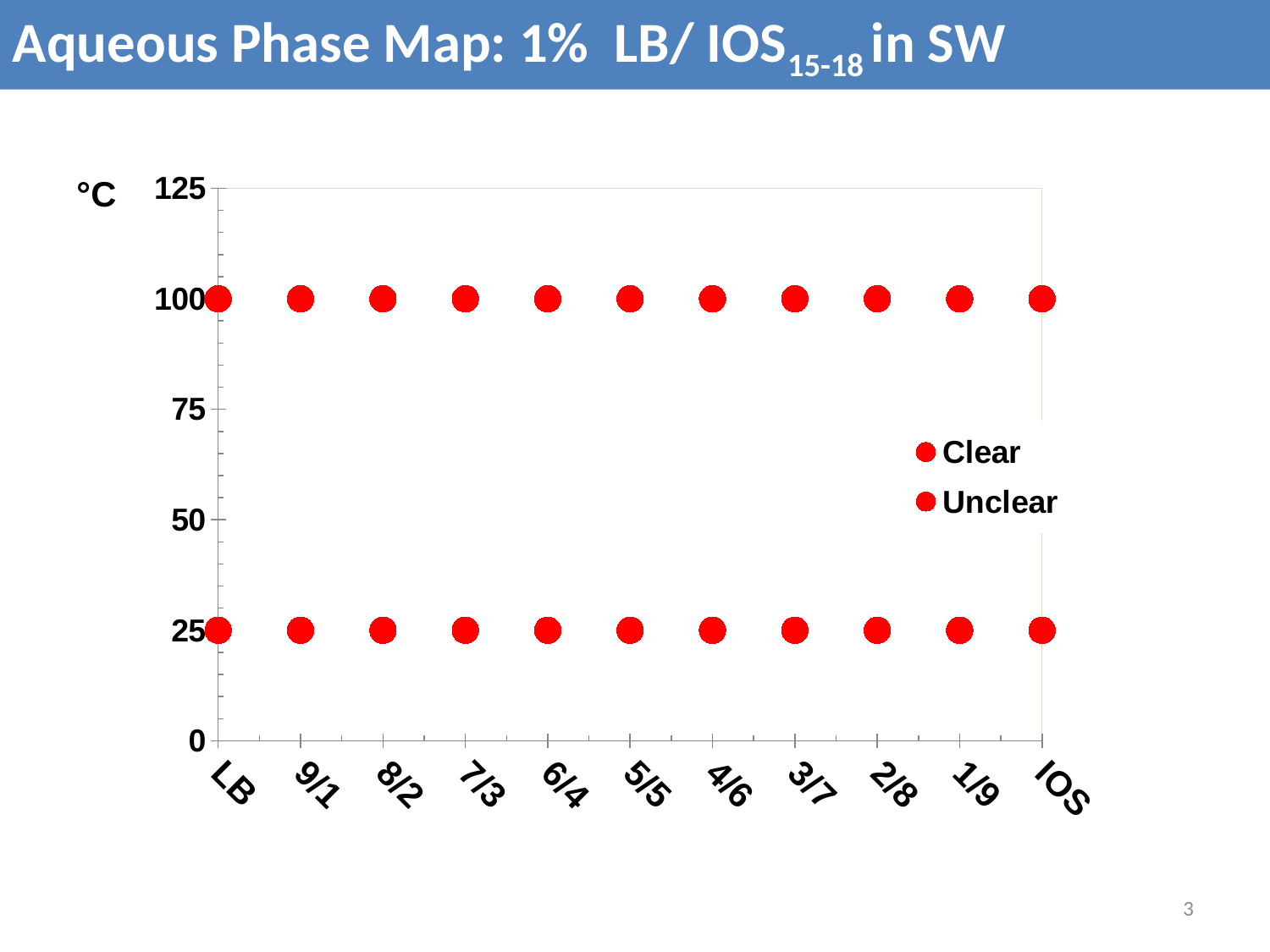
How many series does the legend list? 2 What kind of chart is shown on the slide? scatter chart Do the plotted temperatures rise, fall, or stay the same moving from LB to IOS along the x axis? stay the same What is the lowest temperature at which any point is plotted? 25 What is the highest temperature at which any point is plotted? 100 What unit is shown on the y axis? °C At which two temperatures are points plotted for the 9/1 category? 25 and 100 Is the lower plotted temperature for the LB category greater or less than 50? less What is the difference between the upper and lower plotted temperatures for the 5/5 category? 75 Is the upper plotted temperature for the IOS category greater or less than 75? greater How many categories are labelled along the x axis? 11 What are the two entries in the legend? Clear and Unclear